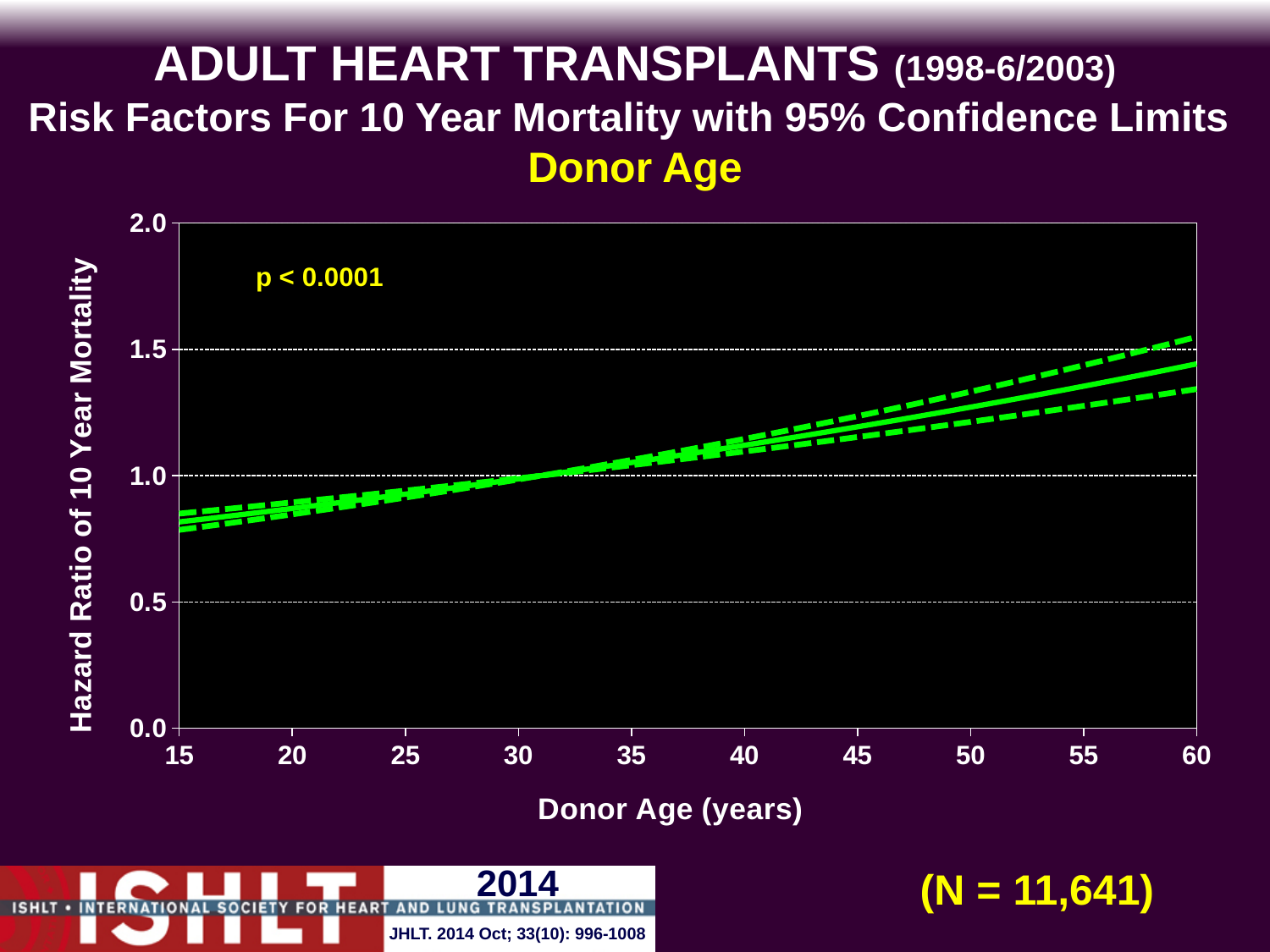
Is the hazard ratio for a donor age of 60 years greater or less than 1.5? less Is the hazard ratio for a donor age of 45 years greater or less than 1.0? greater Is the hazard ratio for a donor age of 15 years greater or less than 1.0? less What is the highest value shown on the y axis of the chart? 2.0 Which donor age has the larger hazard ratio, 20 years or 50 years? 50 years What p-value is printed on the chart? p < 0.0001 Does the hazard ratio of 10 year mortality rise or fall as donor age increases from 15 to 60 years? rise How many lines are plotted on the chart (the estimate plus its confidence limits)? 3 What kind of chart is shown on the slide? line chart